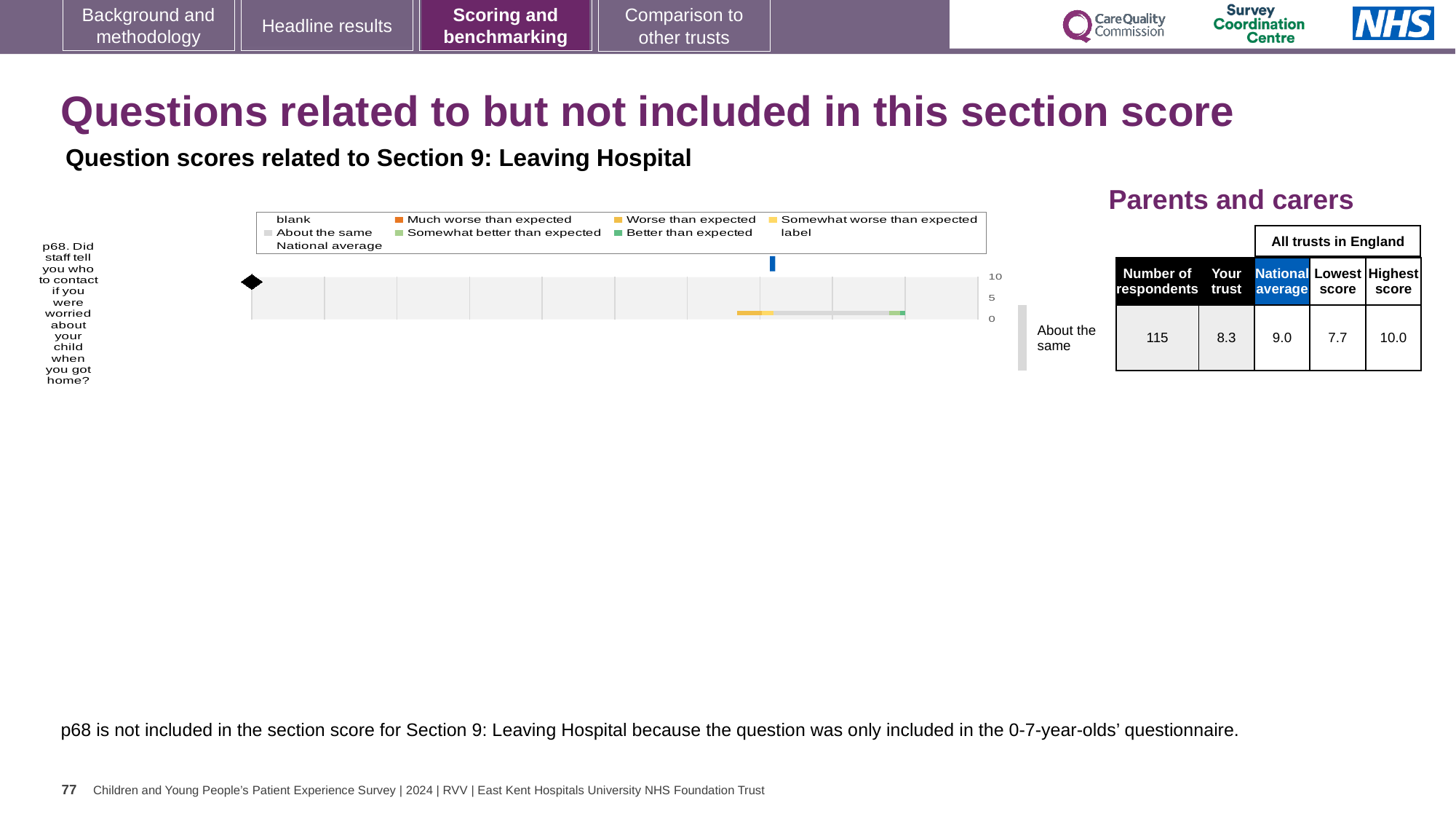
In the table beside the chart, what is the Highest score among all trusts in England for p68? 10.0 What kind of chart is shown on the slide? bar chart How many questions (categories) are plotted in the chart? 1 What is the difference between the National average (9.0) and the 'Your trust' score (8.3) for p68? 0.7 In the table beside the chart, what is the 'Your trust' score for p68? 8.3 Which question is plotted in the chart? p68. Did staff tell you who to contact if you were worried about your child when you got home? What rating label is shown next to the chart for p68? About the same In the table beside the chart, how many respondents answered p68? 115 Which is larger for p68: the 'Your trust' score or the National average? National average What is the highest value shown on the chart's axis? 10 In the table beside the chart, what is the National average score for p68? 9.0 In the table beside the chart, what is the Lowest score among all trusts in England for p68? 7.7